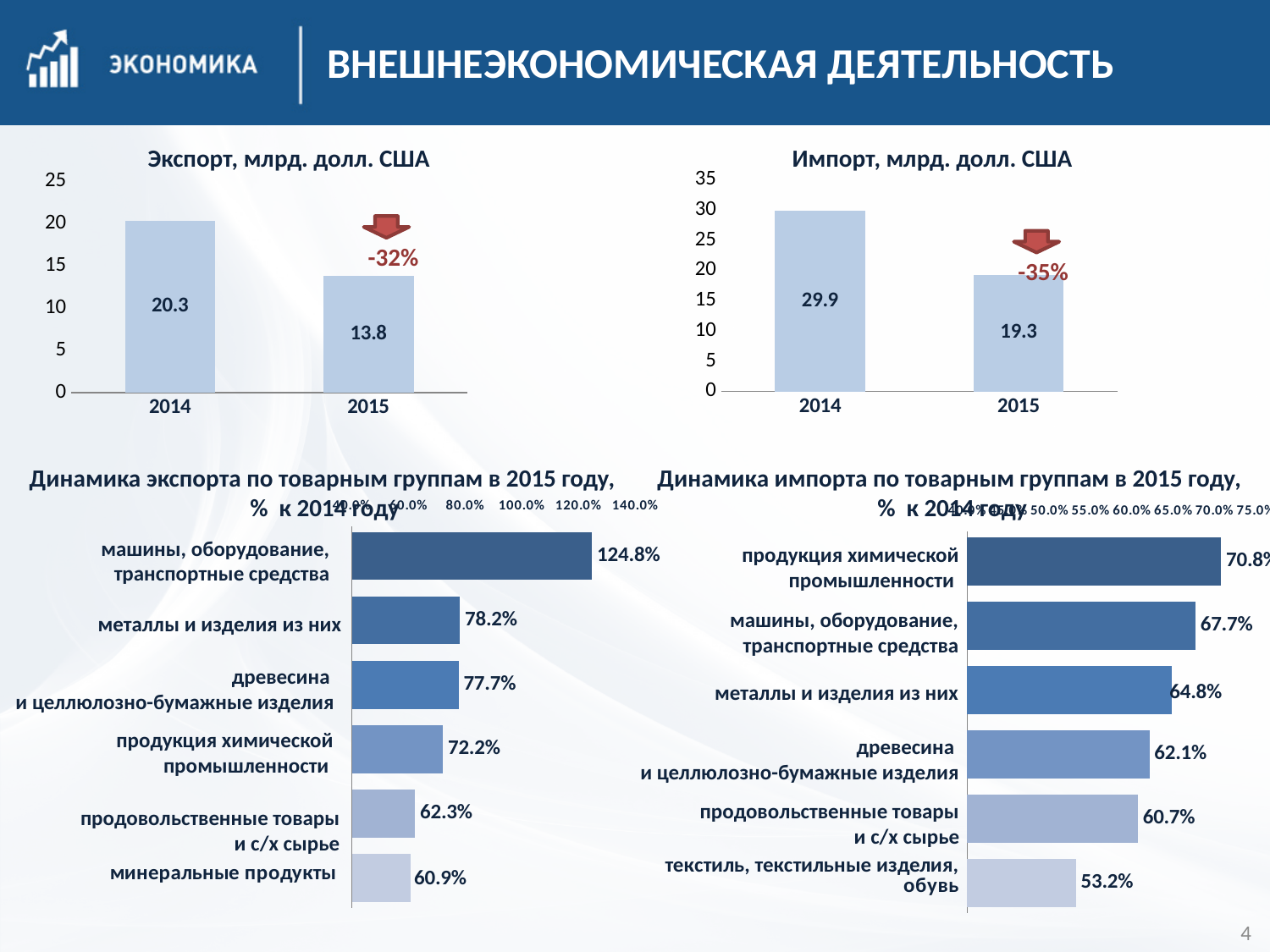
In the chart titled "Динамика импорта по товарным группам в 2015 году, % к 2014 году", what is the difference between the values for "машины, оборудование, транспортные средства" and "металлы и изделия из них"? 2.9% In the chart titled "Импорт, млрд. долл. США", which year has the higher value, 2014 or 2015? 2014 In the chart titled "Динамика экспорта по товарным группам в 2015 году, % к 2014 году", which category has the highest value? машины, оборудование, транспортные средства In the chart titled "Импорт, млрд. долл. США", what is the value for 2015? 19.3 In the chart titled "Экспорт, млрд. долл. США", what is the value for 2014? 20.3 In the chart titled "Динамика импорта по товарным группам в 2015 году, % к 2014 году", which category has the lowest value? текстиль, текстильные изделия, обувь In the chart titled "Динамика экспорта по товарным группам в 2015 году, % к 2014 году", what is the value for "металлы и изделия из них"? 78.2% In the chart titled "Импорт, млрд. долл. США", what percentage change is shown next to the arrow? -35% In the chart titled "Динамика экспорта по товарным группам в 2015 году, % к 2014 году", how many categories are shown? 6 What kind of chart is the one titled "Экспорт, млрд. долл. США"? bar chart In the chart titled "Экспорт, млрд. долл. США", what is the difference between the 2014 and 2015 values? 6.5 In the chart titled "Динамика импорта по товарным группам в 2015 году, % к 2014 году", what is the value for "продукция химической промышленности"? 70.8%